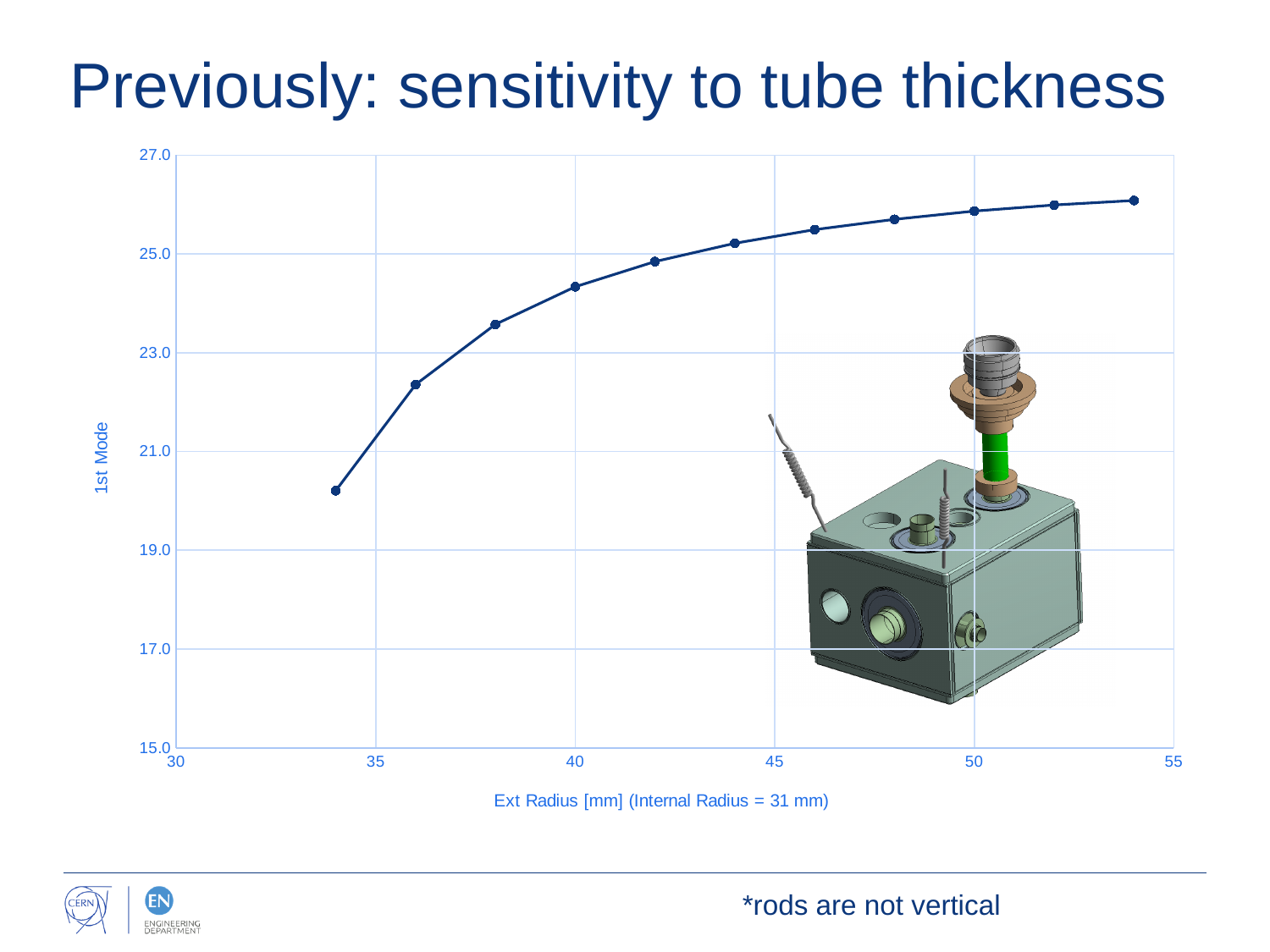
Is the 1st Mode value at an external radius of 36 mm greater or less than 21.0? greater Which has the larger 1st Mode value: an external radius of 36 mm or 40 mm? 40 mm At which external radius is the 1st Mode value highest? 54 Is the 1st Mode value at an external radius of 38 mm greater or less than 23.0? greater How many data points are plotted on the line? 11 Is the 1st Mode value at an external radius of 54 mm greater or less than 27.0? less Does the 1st Mode value rise or fall as the external radius increases? rise What is the label of the x axis? Ext Radius [mm] (Internal Radius = 31 mm) What kind of chart is shown on the slide? line chart At which external radius is the 1st Mode value lowest? 34